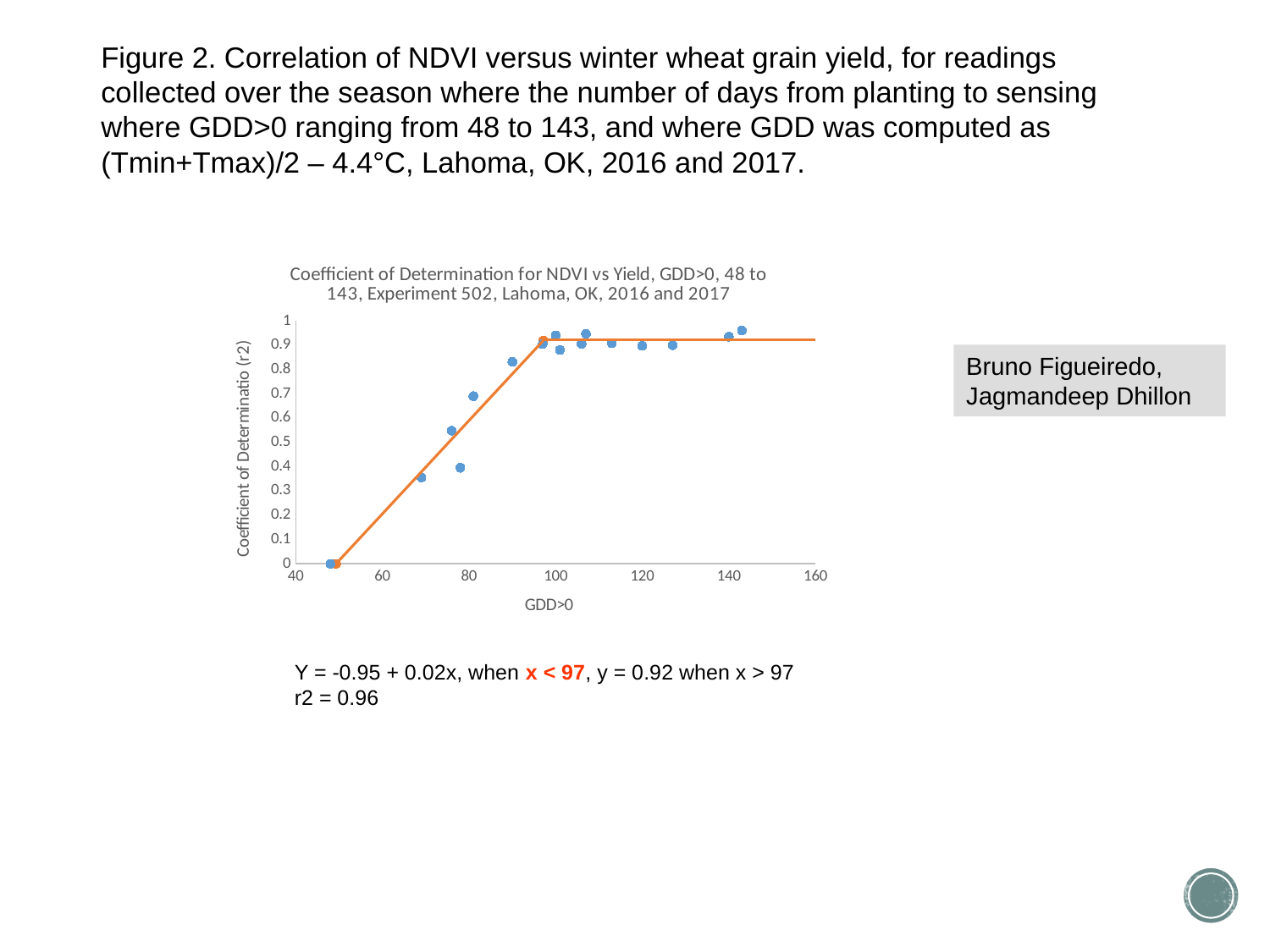
What r2 value is reported for the fitted model below the chart? 0.96 According to the fitted equation below the chart, what is the value of y when x > 97? 0.92 What is the label of the x axis of the chart? GDD>0 What kind of chart is shown on the slide? Scatter chart Which plotted point has the lower r2 value: the one near GDD>0 = 69 or the one near GDD>0 = 90? The one near GDD>0 = 69 Is the leftmost plotted point's r2 value greater or less than 0.1? less Is the r2 value of the plotted point near GDD>0 = 90 greater or less than 0.7? greater What is the highest value shown on the y axis of the chart? 1 Is the highest plotted r2 value greater or less than 0.9? greater Do the plotted r2 values generally rise or fall as GDD>0 increases from 40 to 100? Rise What is the title of the chart? Coefficient of Determination for NDVI vs Yield, GDD>0, 48 to 143, Experiment 502, Lahoma, OK, 2016 and 2017 What is the highest value shown on the x axis of the chart? 160